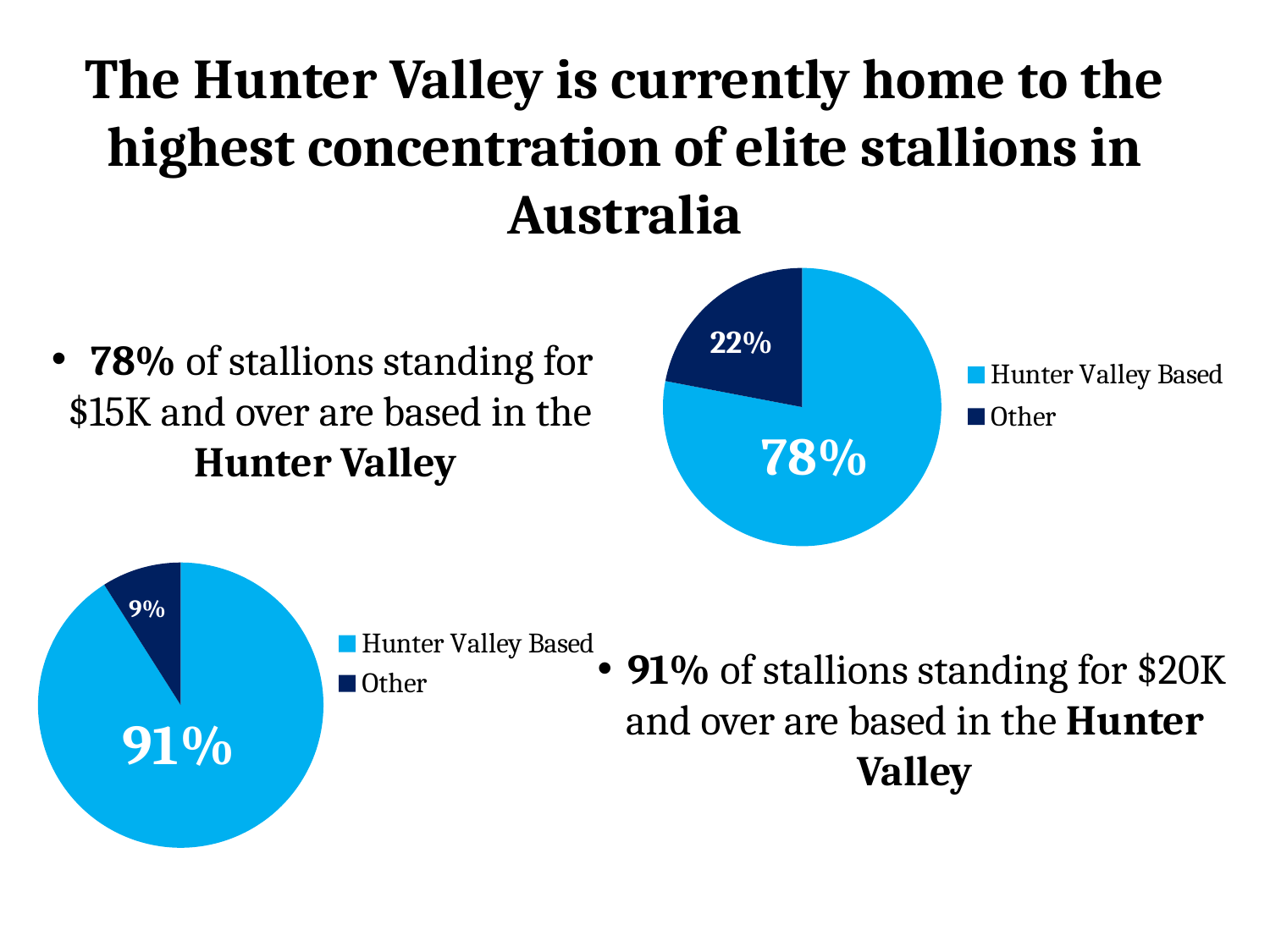
In the top-right pie chart, what share is labelled for Other? 22% In the top-right pie chart, what share is labelled for Hunter Valley Based? 78% In the top-right pie chart, which slice is the largest? Hunter Valley Based In the bottom-left pie chart, what is the difference between the Hunter Valley Based share and the Other share? 82% In the bottom-left pie chart, what share is labelled for Hunter Valley Based? 91% In the bottom-left pie chart, which slice is the smallest? Other Which chart shows a larger Hunter Valley Based share, the top-right pie chart or the bottom-left pie chart? the bottom-left pie chart How many slices does the bottom-left pie chart have? 2 In the top-right pie chart, what colour is the Other slice? dark navy blue In the bottom-left pie chart, what share is labelled for Other? 9% What type of chart is the top-right chart? pie chart In the top-right pie chart, what is the difference between the Hunter Valley Based share and the Other share? 56%